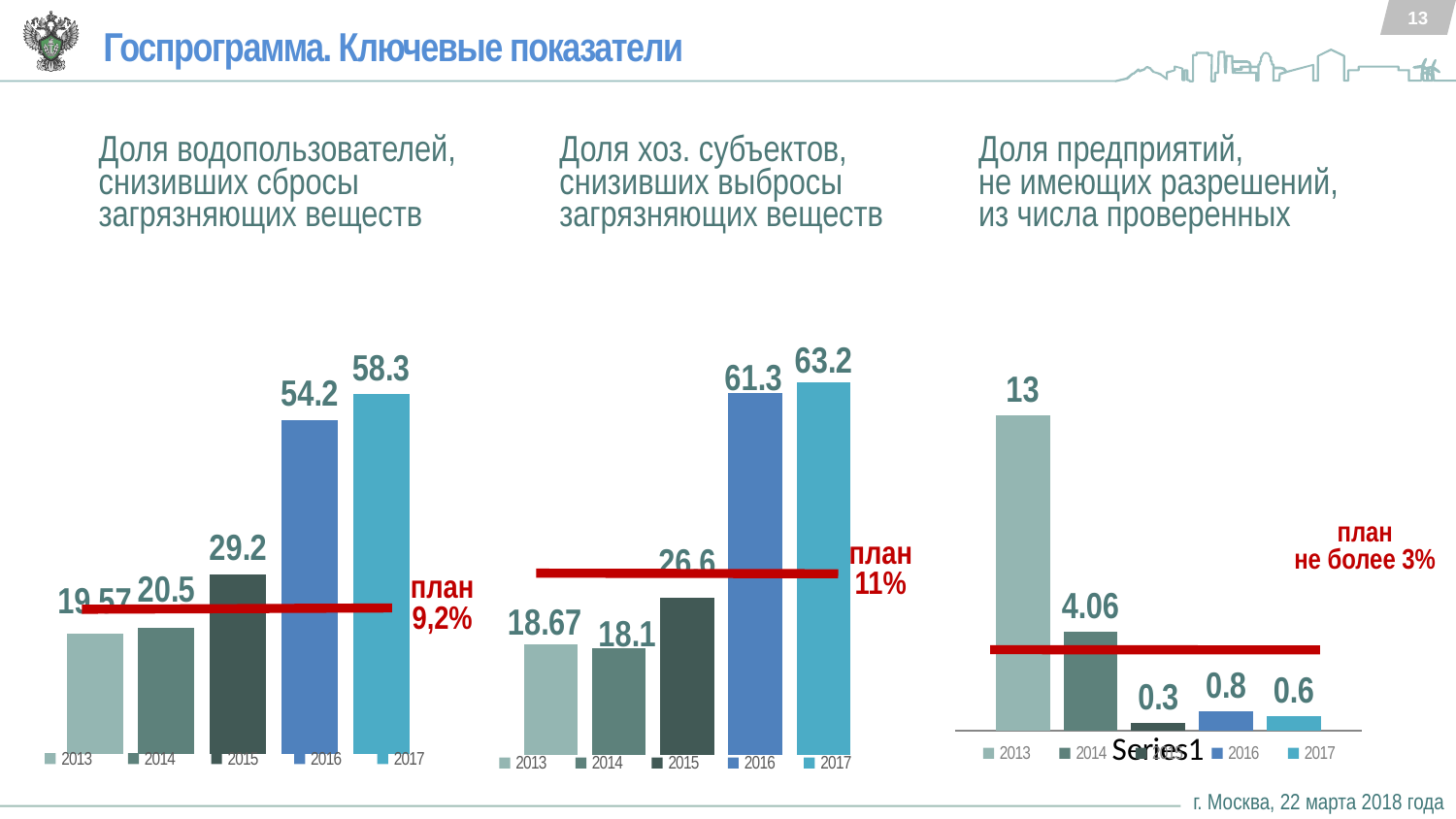
What type of chart is the middle chart (Доля хоз. субъектов, снизивших выбросы загрязняющих веществ)? Bar chart In the left chart (Доля водопользователей, снизивших сбросы загрязняющих веществ), what is the difference between the 2017 and 2016 values? 4.1 In the middle chart (Доля хоз. субъектов, снизивших выбросы загрязняющих веществ), what plan value is shown by the red line? 11% In the middle chart (Доля хоз. субъектов, снизивших выбросы загрязняющих веществ), which year has the lowest value? 2014 In the right chart (Доля предприятий, не имеющих разрешений, из числа проверенных), what is the difference between the 2013 and 2014 values? 8.94 In the right chart (Доля предприятий, не имеющих разрешений, из числа проверенных), which year has the lowest value? 2015 In the middle chart (Доля хоз. субъектов, снизивших выбросы загрязняющих веществ), what is the value for 2013? 18.67 In the middle chart (Доля хоз. субъектов, снизивших выбросы загрязняющих веществ), which is larger, the value for 2015 or the value for 2016? 2016 In the right chart (Доля предприятий, не имеющих разрешений, из числа проверенных), what is the value for 2014? 4.06 How many bars (years) are plotted in the left chart (Доля водопользователей, снизивших сбросы загрязняющих веществ)? 5 In the left chart (Доля водопользователей, снизивших сбросы загрязняющих веществ), which year has the highest value? 2017 In the left chart (Доля водопользователей, снизивших сбросы загрязняющих веществ), what is the value for 2016? 54.2